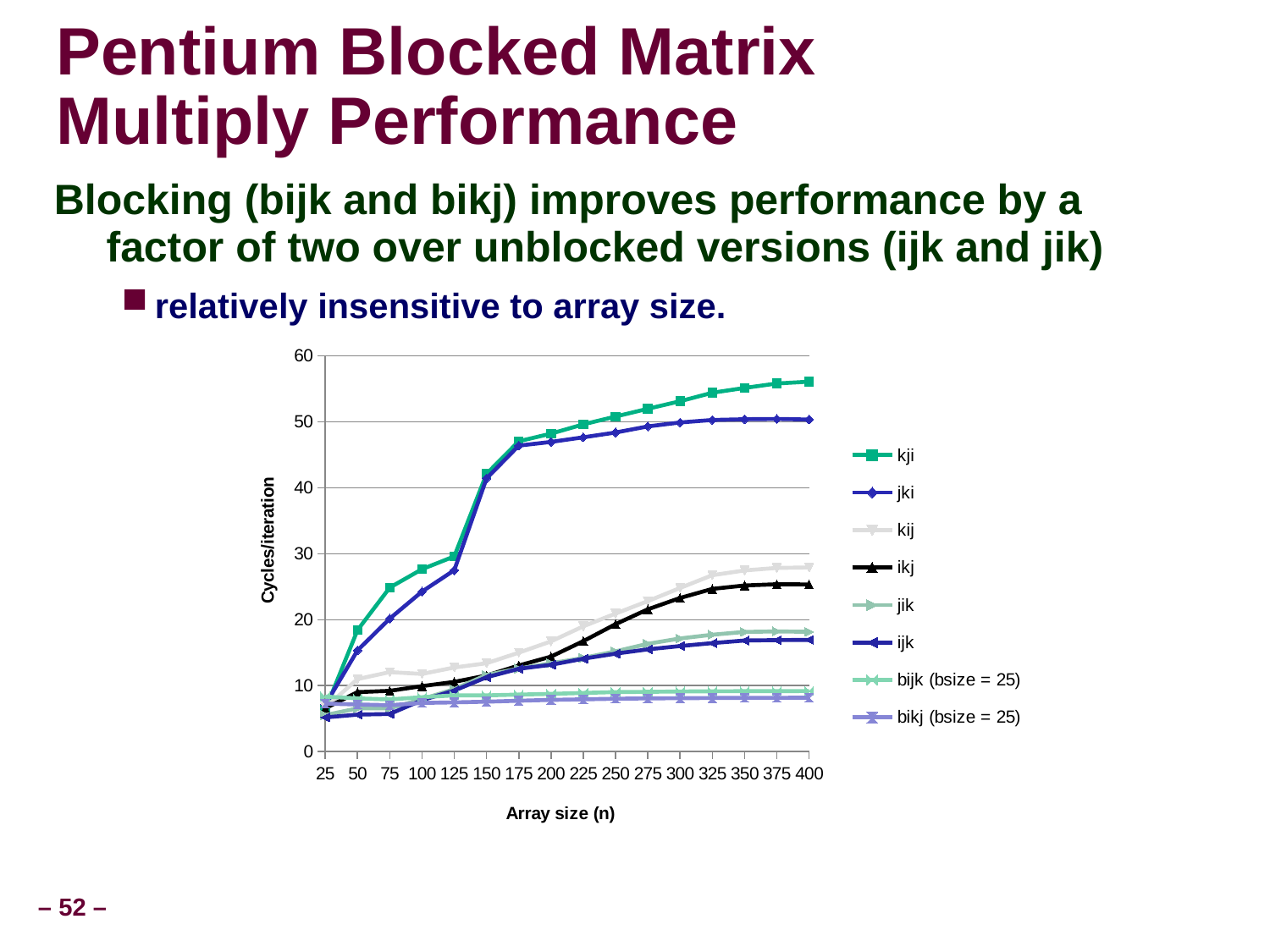
Is the value for bikj (bsize = 25) at array size 400 greater or less than 10? less What kind of chart is shown on the slide? line chart What is the label of the y axis? Cycles/iteration Does the kji series rise or fall as array size increases? rise At array size 400, which is larger, kji or jki? kji Is the value for kji at array size 400 greater or less than 50? greater Which series has the highest value at array size 400? kji Is the value for ikj at array size 400 greater or less than 30? less How many series does the legend list? 8 What is the label of the x axis? Array size (n) How many array size values are plotted along the x axis? 16